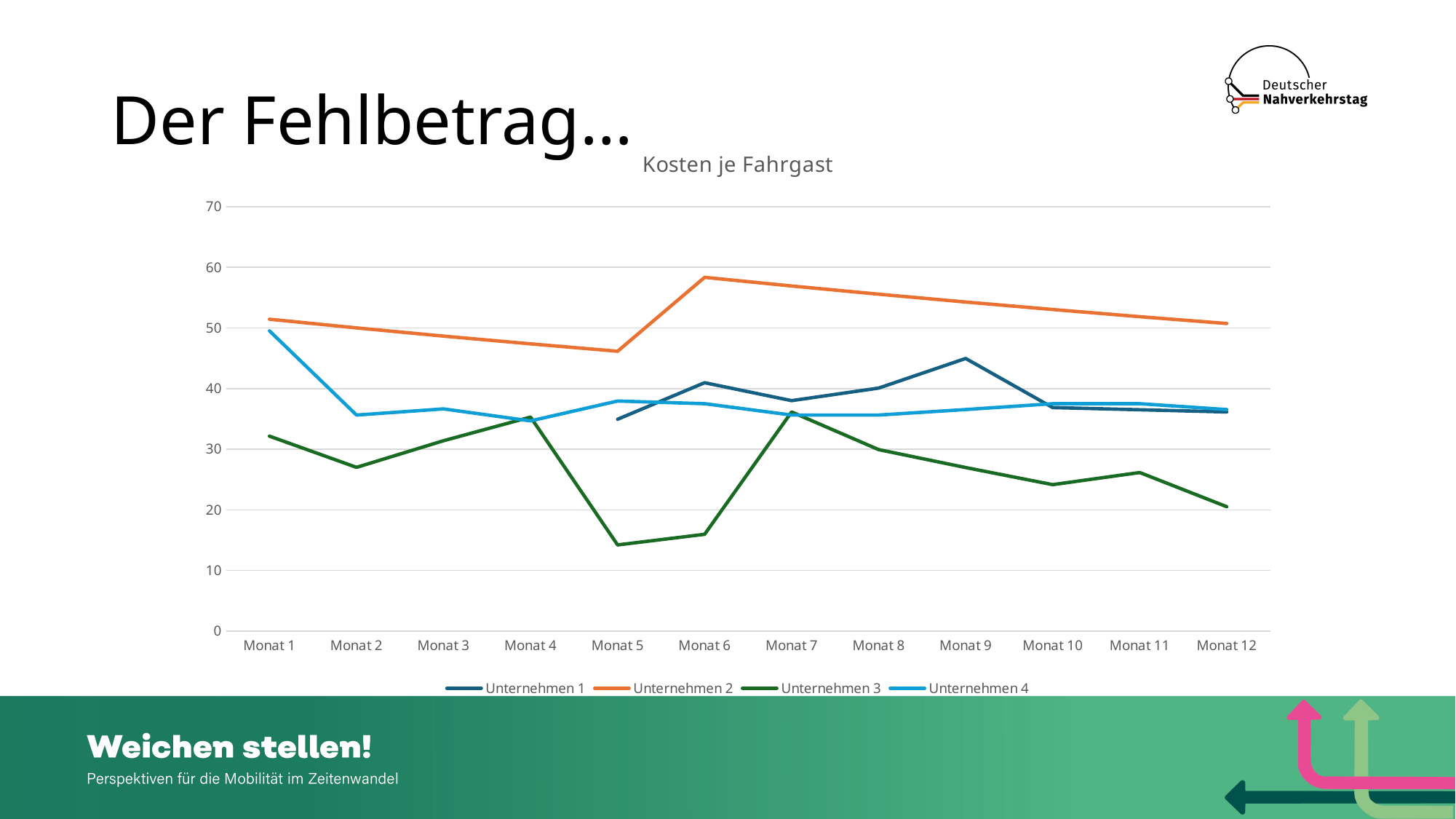
In which month does Unternehmen 1 reach its highest value? Monat 9 For Unternehmen 4, which is larger: the value in Monat 1 or in Monat 2? Monat 1 Is the value for Unternehmen 3 in Monat 5 greater or less than 20? less How many series does the legend list? 4 Which series has the highest value in Monat 6? Unternehmen 2 Which series has the lowest value in Monat 12? Unternehmen 3 How many months are shown on the x axis? 12 Is the value for Unternehmen 2 in Monat 6 greater or less than 50? greater Is the value for Unternehmen 4 in Monat 1 greater or less than 40? greater What kind of chart is shown on the slide? line chart Does the line for Unternehmen 2 rise or fall from Monat 6 to Monat 12? fall What is the title of the chart? Kosten je Fahrgast